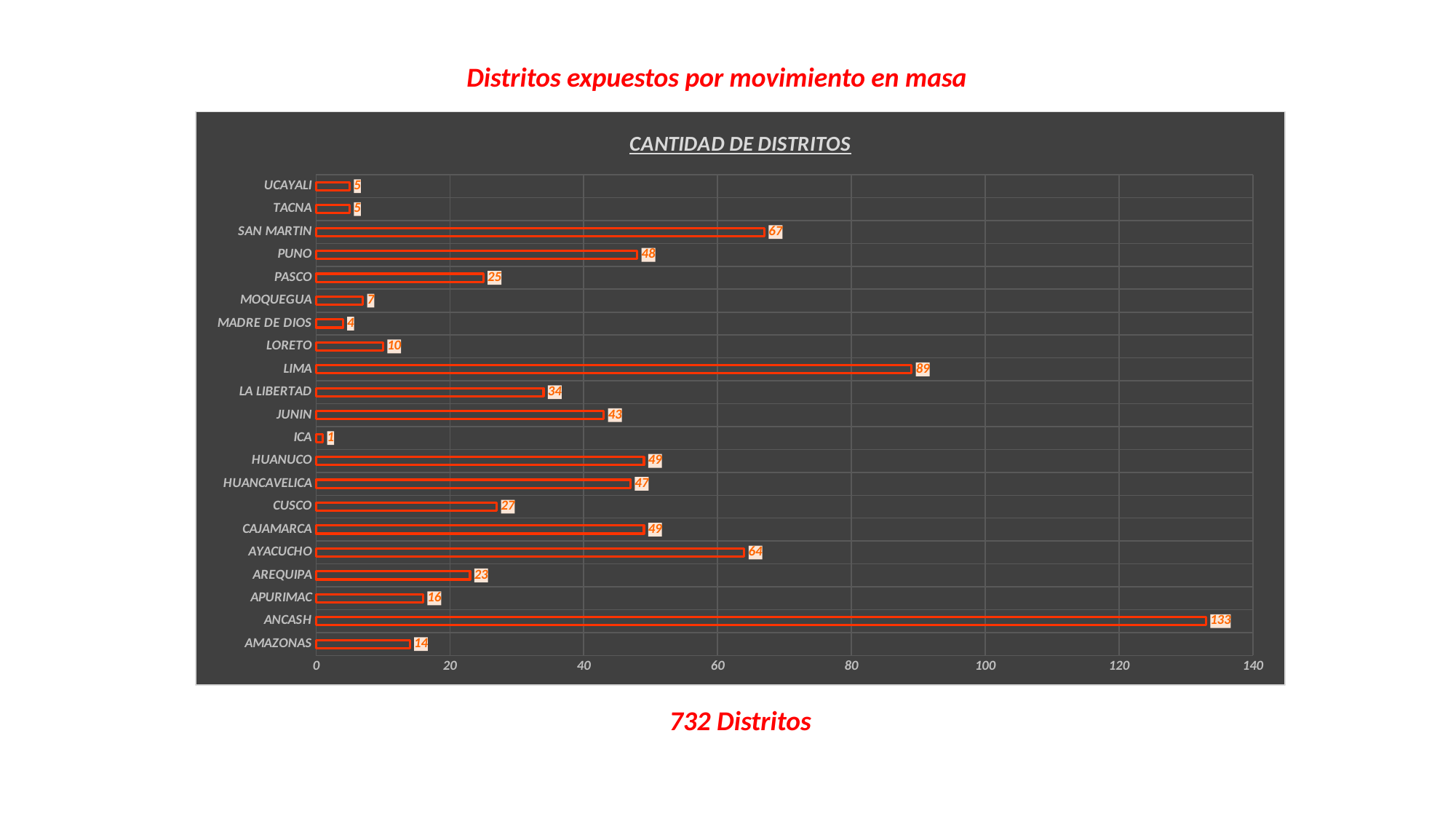
Which category has the highest value? ANCASH Which is larger, the value for AYACUCHO or the value for PUNO? AYACUCHO What is the difference between the values for ANCASH and LIMA? 44 What is the title of the chart? CANTIDAD DE DISTRITOS What is the difference between the values for HUANUCO and CUSCO? 22 What kind of chart is shown? bar chart What is the value for SAN MARTIN? 67 What is the value for LIMA? 89 Which category has the lowest value? ICA How many categories are shown on the chart? 21 What is the value for APURIMAC? 16 Is the value for JUNIN greater or less than 40? greater